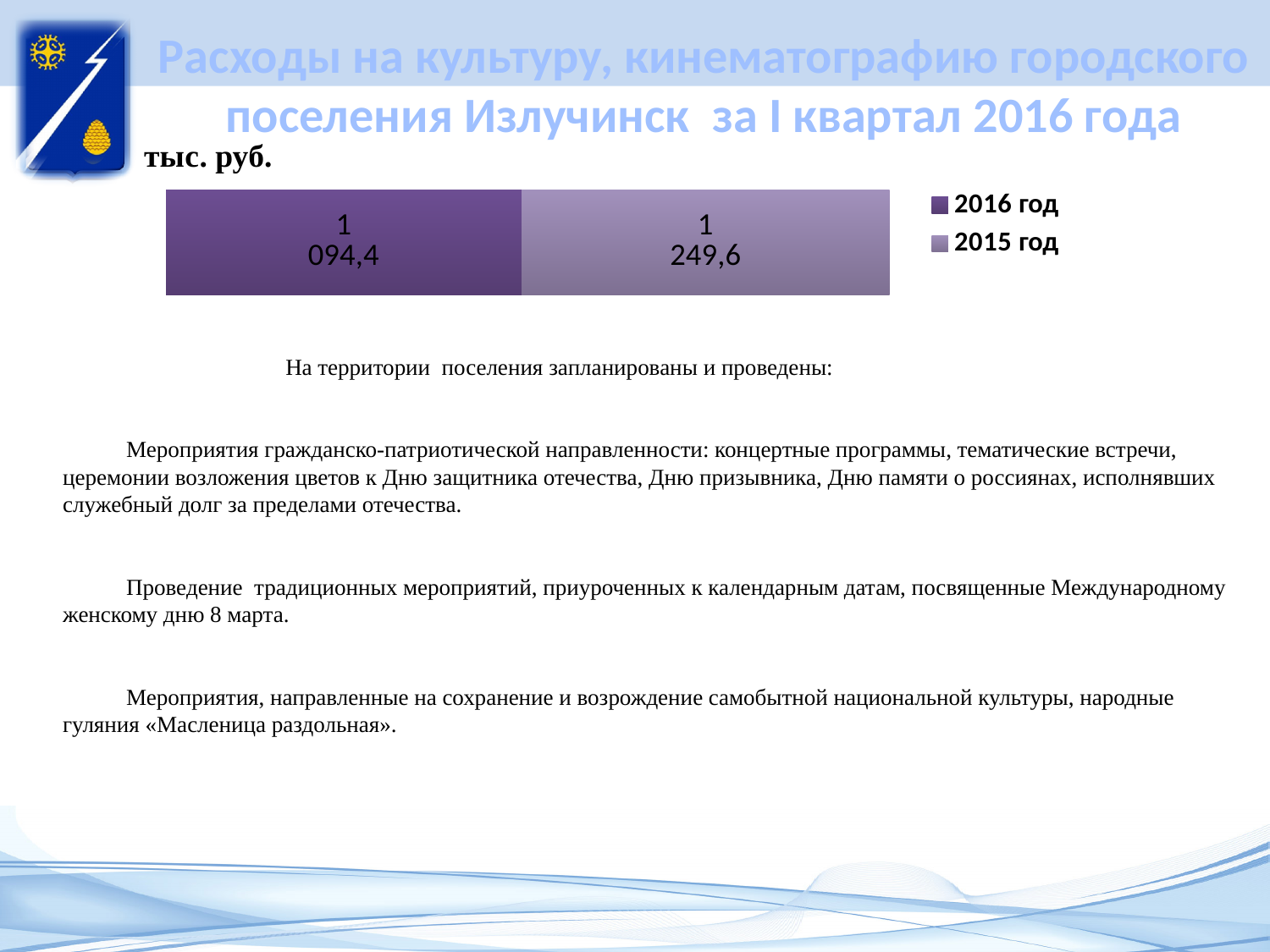
What is the difference between the 2015 год and 2016 год values? 155,2 How many series does the legend list? 2 What is the value for 2016 год in the chart? 1 094,4 What kind of chart is shown on the slide? bar chart What unit is stated above the chart? тыс. руб. Is the value for 2016 год larger or smaller than the value for 2015 год? smaller Which legend entry is shown in the darker purple colour? 2016 год Which year has the higher expenditure value in the chart? 2015 год Which year has the lower expenditure value in the chart? 2016 год What is the value for 2015 год in the chart? 1 249,6 What is the total of the two segments in the stacked bar? 2 344,0